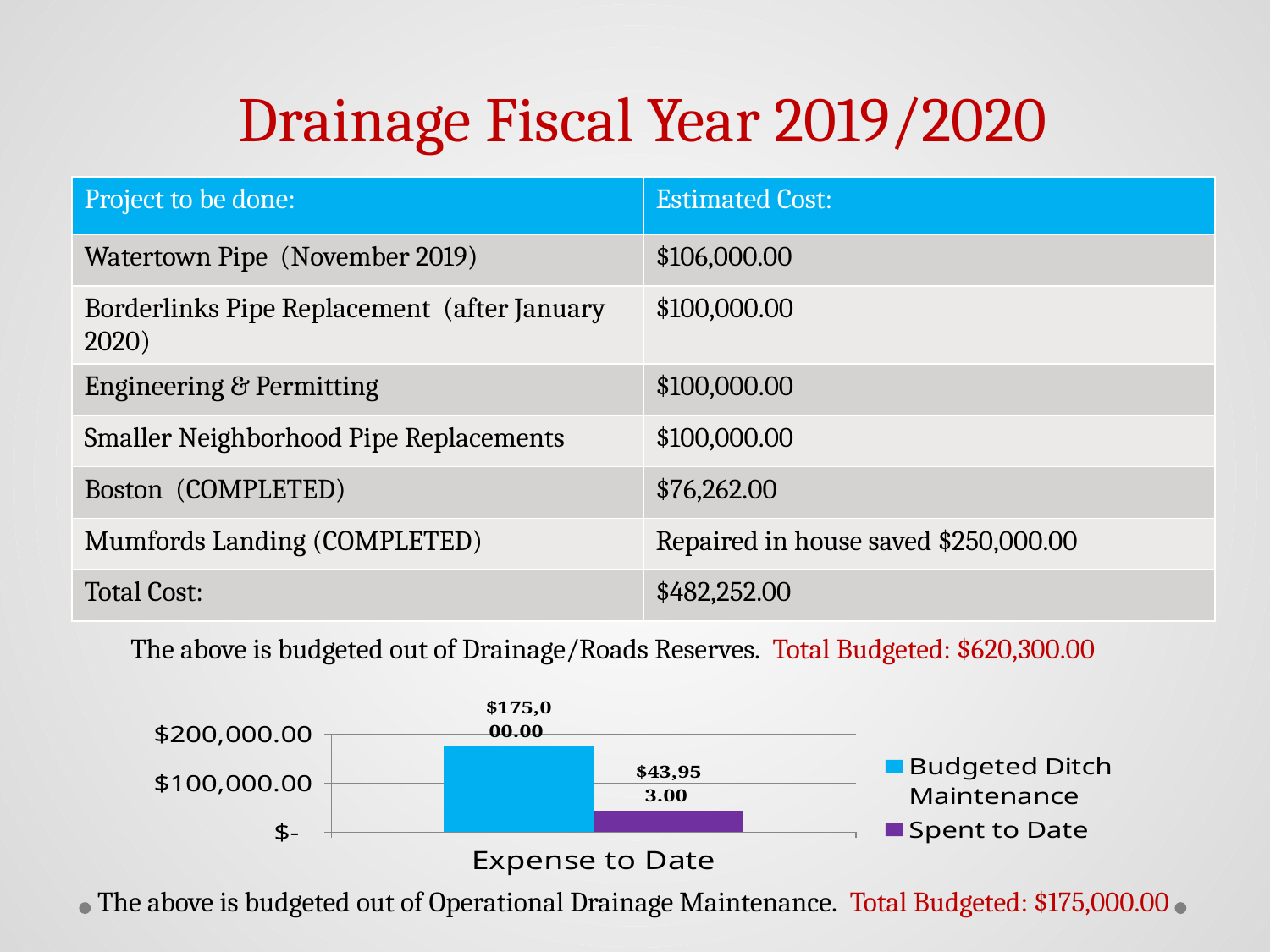
What is the value of Budgeted Ditch Maintenance in the chart? $175,000.00 What kind of chart is shown on the slide? Bar chart Is the value for Budgeted Ditch Maintenance greater or less than $100,000.00? greater What is the difference between Budgeted Ditch Maintenance and Spent to Date in the chart? $131,047.00 How many categories are shown on the x axis of the chart? 1 Which series has the lowest value in the chart? Spent to Date What is the value of Spent to Date in the chart? $43,953.00 How many series does the chart legend list? 2 Which series has the higher value in the chart, Budgeted Ditch Maintenance or Spent to Date? Budgeted Ditch Maintenance Is the value for Spent to Date greater or less than $100,000.00? less What is the category label shown on the x axis of the chart? Expense to Date What colour is the Spent to Date bar in the chart? Purple